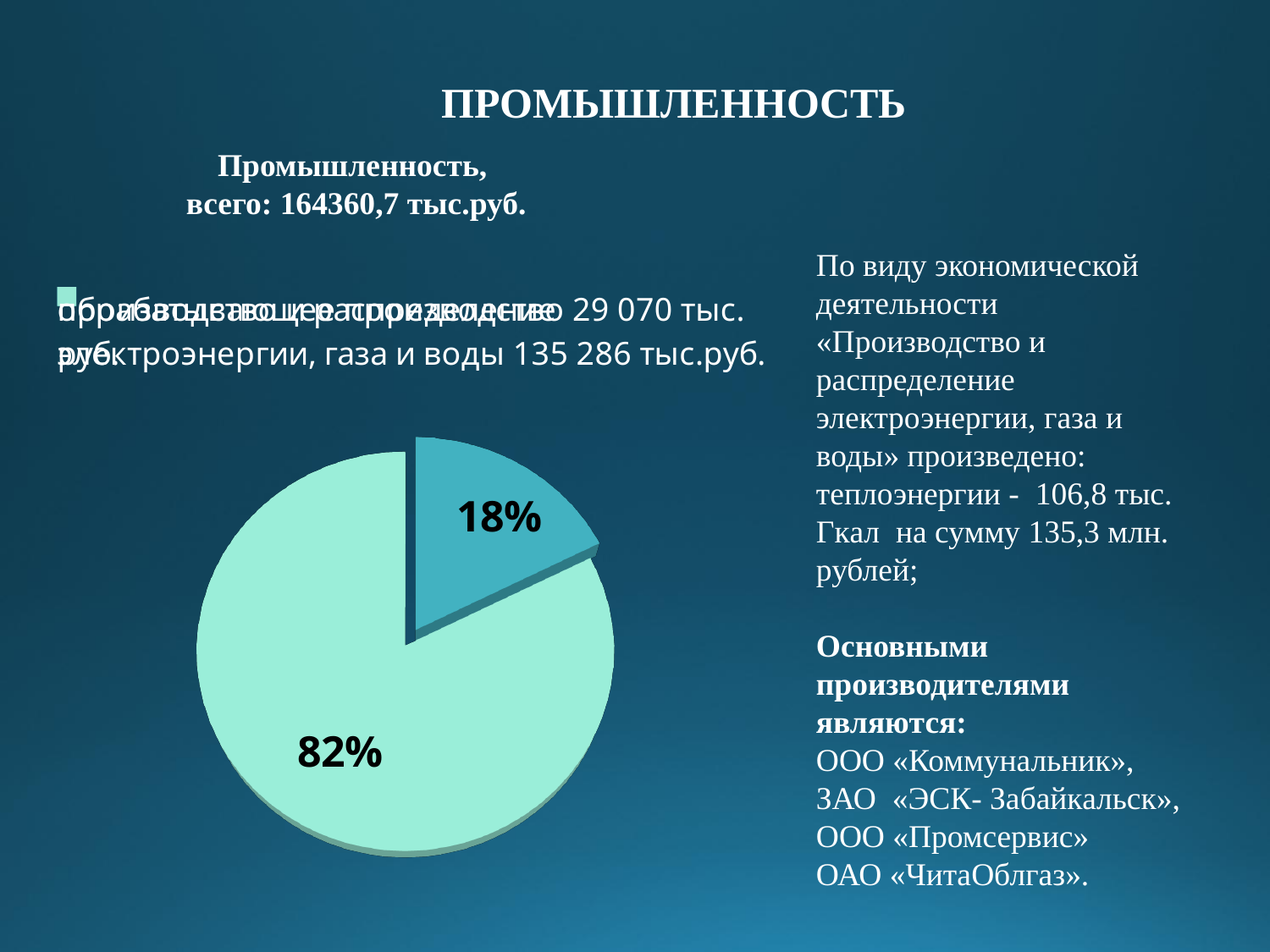
Which slice of the pie chart is larger, the one labelled 82% or the one labelled 18%? 82% Is the share of the larger slice of the pie chart greater or less than 50%? greater Is the share of the smaller slice of the pie chart greater or less than 50%? less What kind of chart is shown on the slide? pie chart What total value is stated in the chart title above the pie chart? 164360,7 тыс.руб. How many slices does the pie chart have? 2 What is the share of the smallest slice of the pie chart? 18% What is the share of the largest slice of the pie chart? 82% Which slice of the pie chart is drawn in the darker teal colour, the 82% slice or the 18% slice? 18% What is the difference in percentage points between the two slices of the pie chart? 64 percentage points Do the two slices of the pie chart add up to 100%? yes